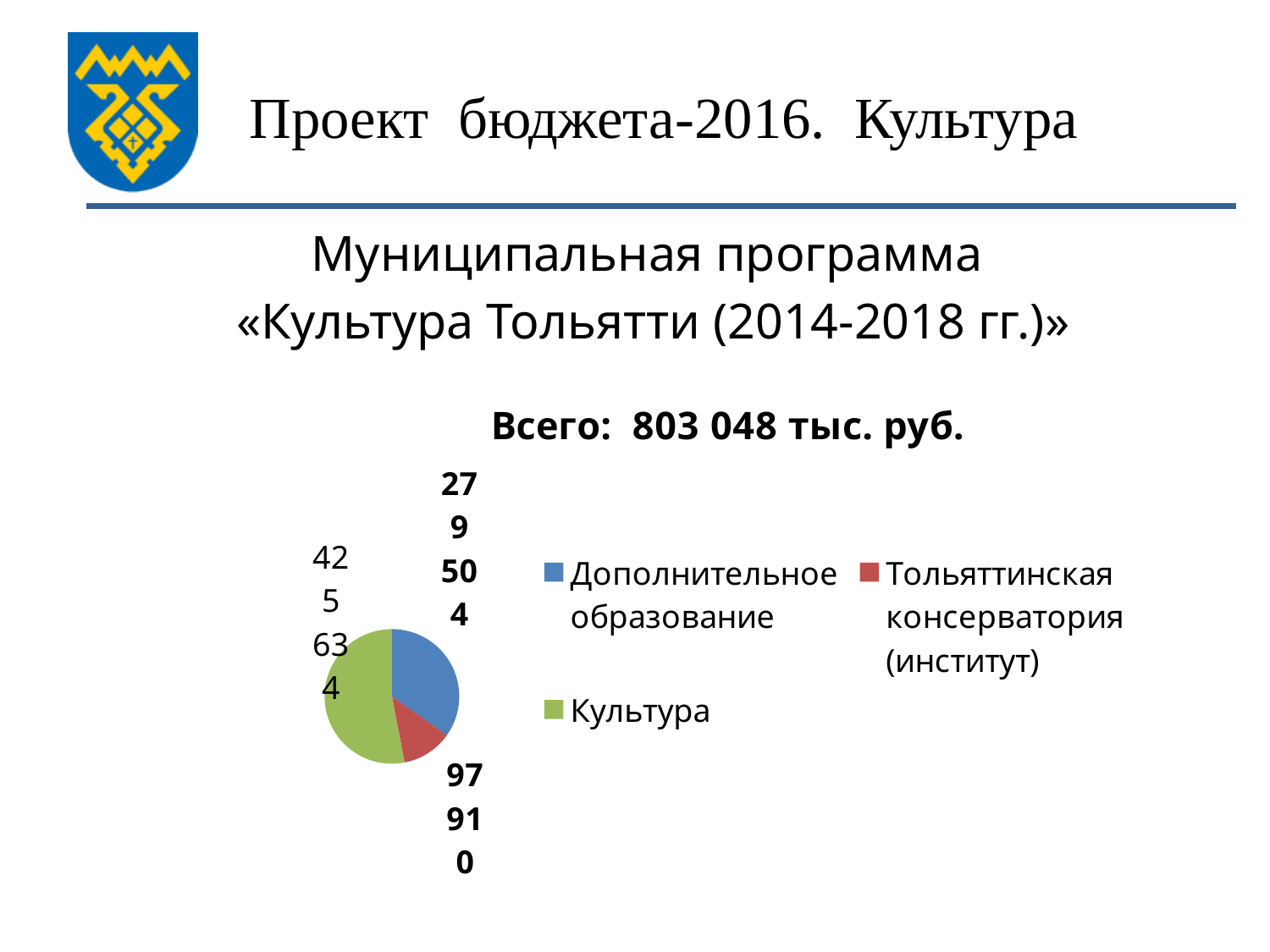
What is the title of the chart? Всего: 803 048 тыс. руб. What colour is the slice for Культура? green What is the value for Дополнительное образование? 279 504 Which is larger, Дополнительное образование or Тольяттинская консерватория (институт)? Дополнительное образование How many slices does the pie chart have? 3 What is the difference between the values for Культура and Дополнительное образование? 146 130 What is the value for Культура? 425 634 What type of chart is shown on the slide? pie chart Which category has the largest slice? Культура What is the value for Тольяттинская консерватория (институт)? 97 910 How many entries does the legend list? 3 Which category has the smallest slice? Тольяттинская консерватория (институт)